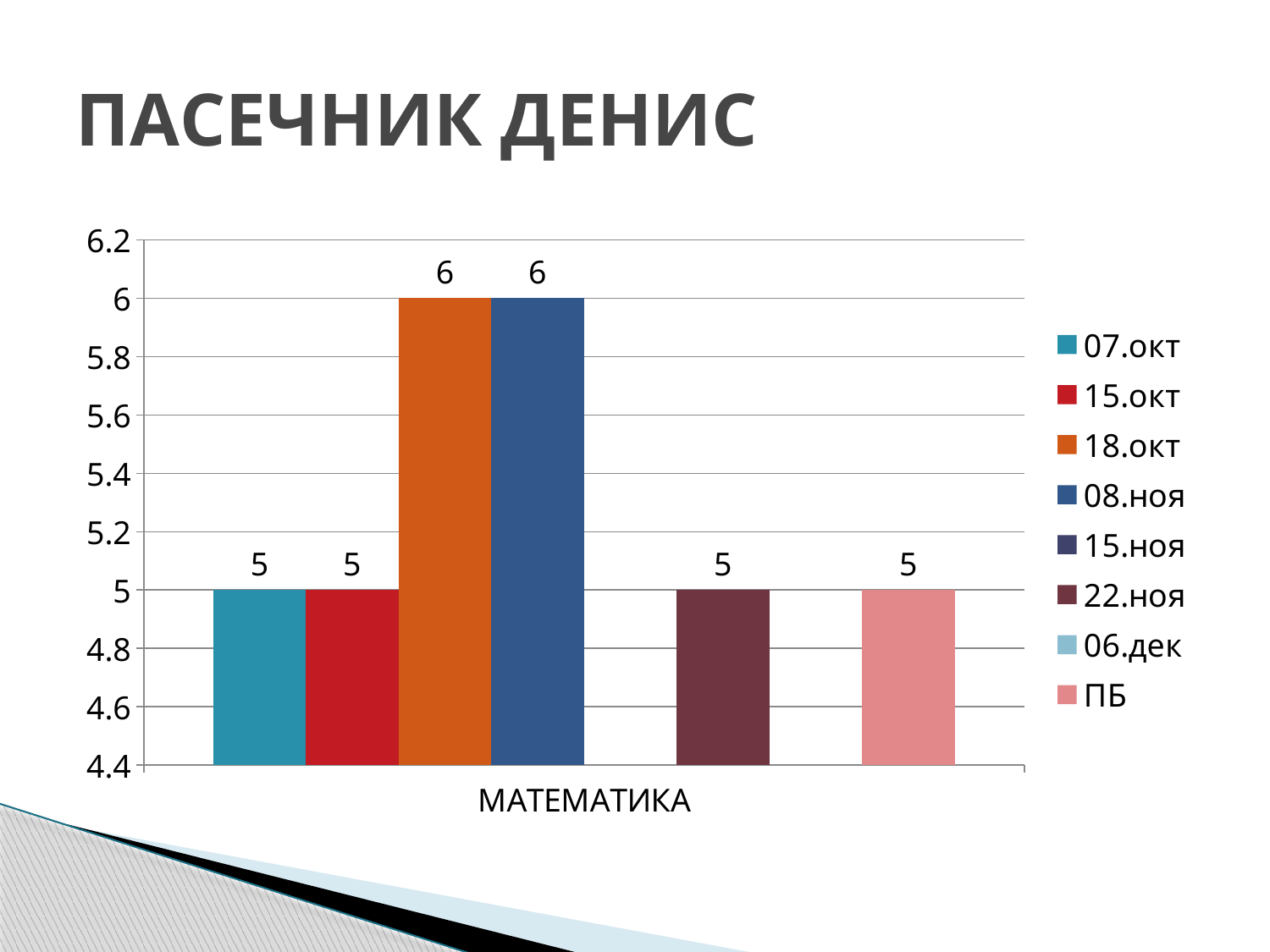
What is the value for the 08.ноя series? 6 What is the value for the 18.окт series? 6 What is the value for the 15.окт series? 5 Which is larger, the value for 08.ноя or the value for 22.ноя? 08.ноя How many series does the legend list? 8 What is the value for the 07.окт series? 5 What kind of chart is shown on the slide? bar chart What is the category label shown on the x axis? МАТЕМАТИКА Is the value for 18.окт greater or less than 5.6? greater What is the title of the slide? ПАСЕЧНИК ДЕНИС What is the difference between the value for 18.окт and the value for 15.окт? 1 What is the value for the ПБ series? 5